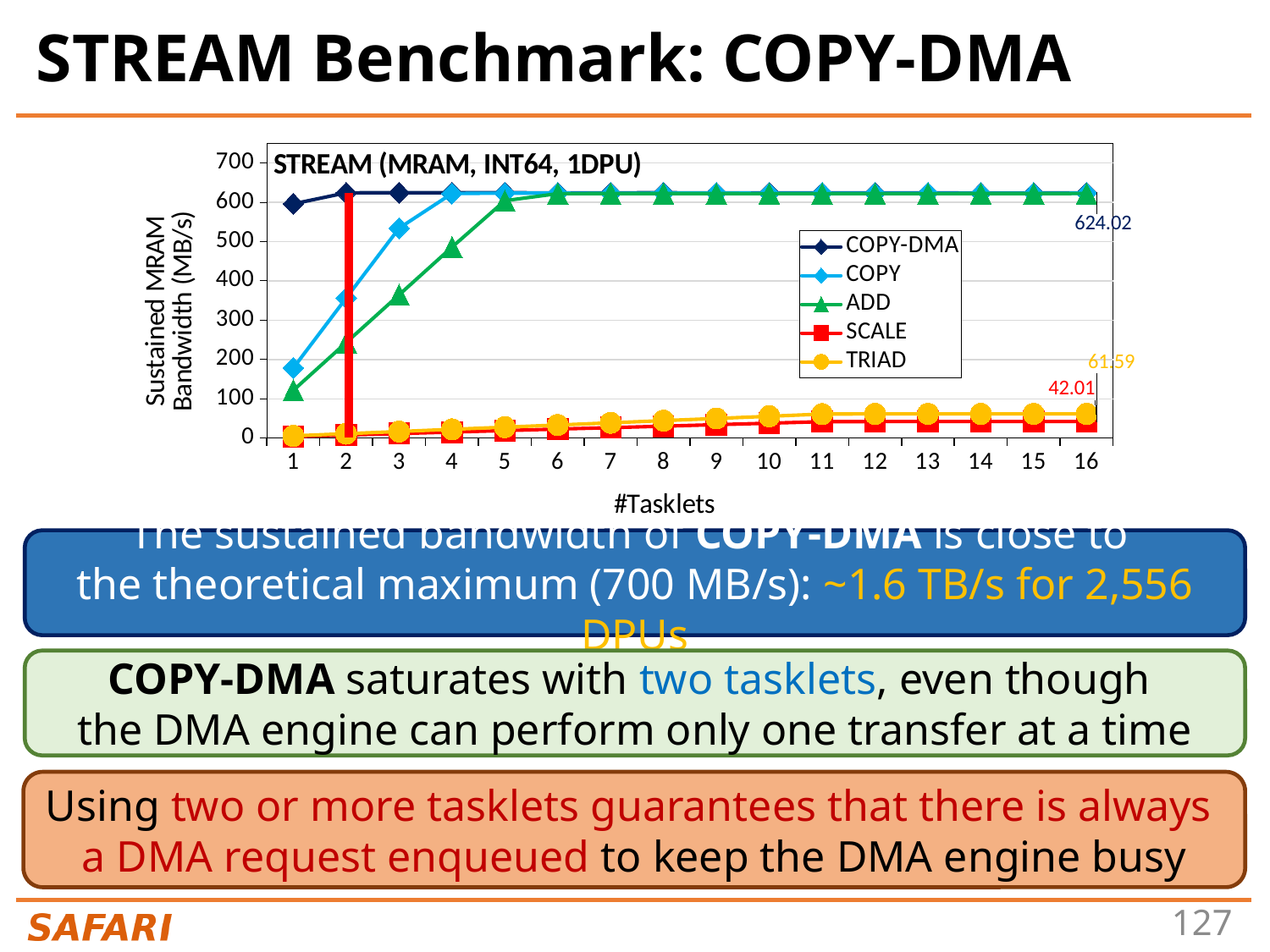
How many series does the chart legend list? 5 What is the title printed inside the chart area? STREAM (MRAM, INT64, 1DPU) What is the labelled value of COPY-DMA at 16 tasklets? 624.02 Which is larger at 2 tasklets, COPY or ADD? COPY What is the labelled value of TRIAD at 16 tasklets? 61.59 What is the difference between the labelled TRIAD and SCALE values at 16 tasklets? 19.58 Which series has the lowest bandwidth at 16 tasklets? SCALE What is the labelled value of SCALE at 16 tasklets? 42.01 What is the label of the x axis? #Tasklets Is the value for ADD at 1 tasklet greater or less than 200? less How many tasklet counts are plotted along the x axis? 16 What kind of chart is shown on the slide? line chart